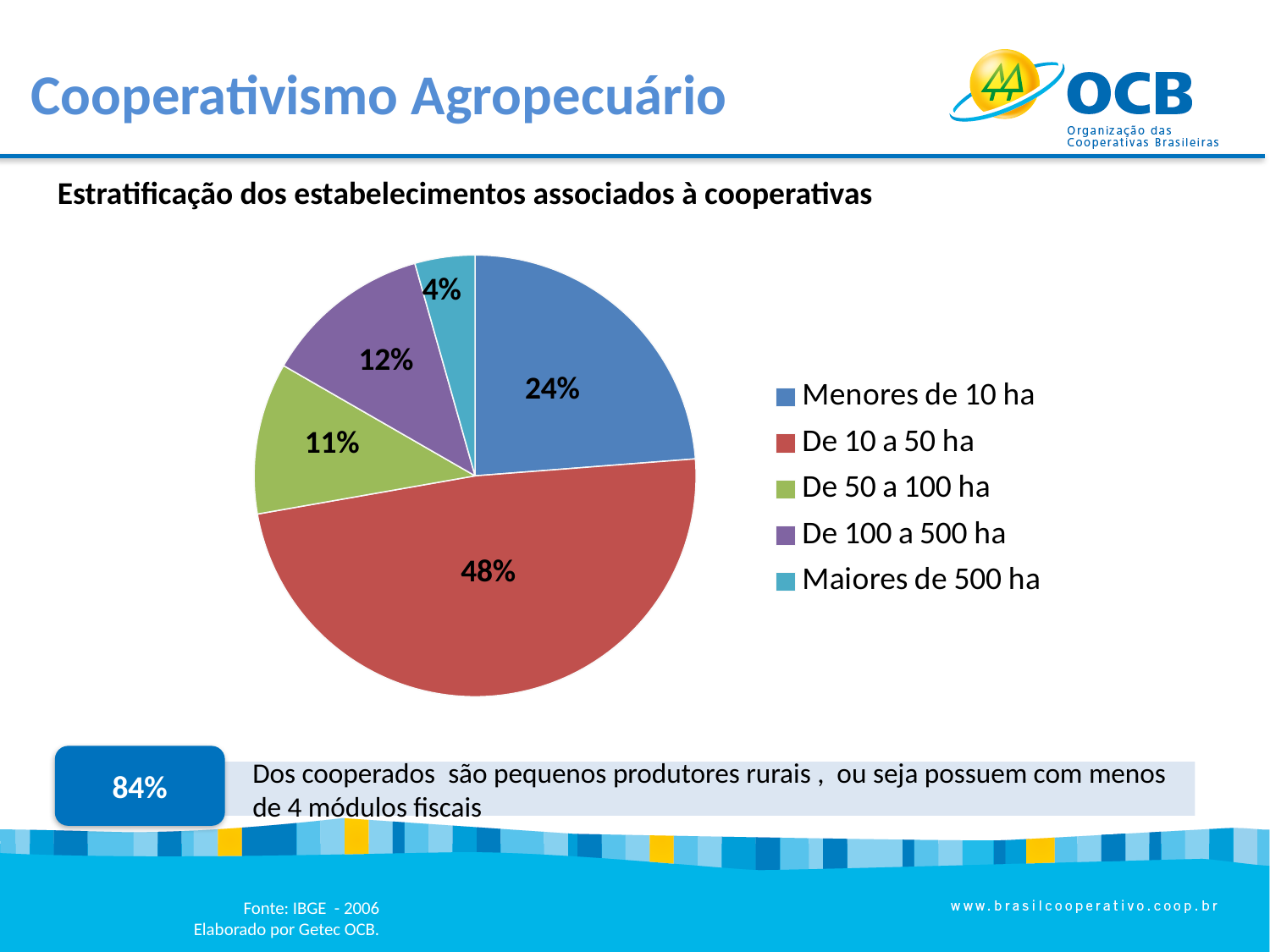
What is the difference between the shares of "De 10 a 50 ha" and "Menores de 10 ha"? 24% What share of the pie does "Menores de 10 ha" represent? 24% Which category has the largest slice of the pie? De 10 a 50 ha Which is larger, the share for "Menores de 10 ha" or the share for "De 100 a 500 ha"? Menores de 10 ha What share of the pie does "De 100 a 500 ha" represent? 12% What share of the pie does "Maiores de 500 ha" represent? 4% What colour is the slice for "De 50 a 100 ha"? green Which category has the smallest slice of the pie? Maiores de 500 ha How many categories does the legend list? 5 What kind of chart is shown on the slide? pie chart